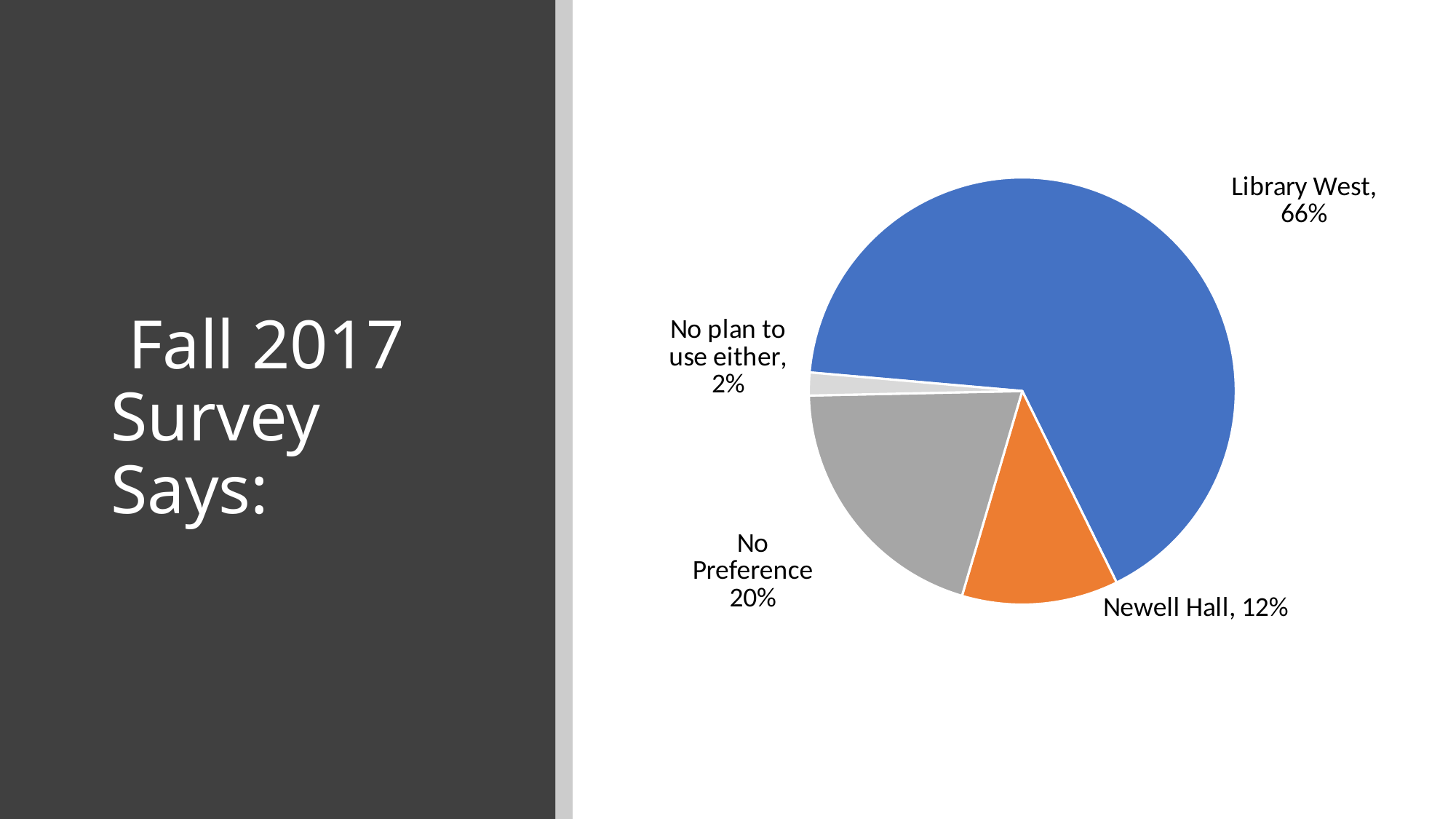
What is the difference in percentage points between Newell Hall and No plan to use either? 10 Which category has the largest slice? Library West What is the value for Newell Hall? 12% How many slices does the pie chart have? 4 Which is larger, No Preference or Newell Hall? No Preference What is the value for No Preference? 20% What share of the pie does Library West have? 66% What is the value for No plan to use either? 2% What colour is the Newell Hall slice? orange What is the difference in percentage points between Library West and No Preference? 46 What kind of chart is shown on the slide? pie chart Which category has the smallest slice? No plan to use either